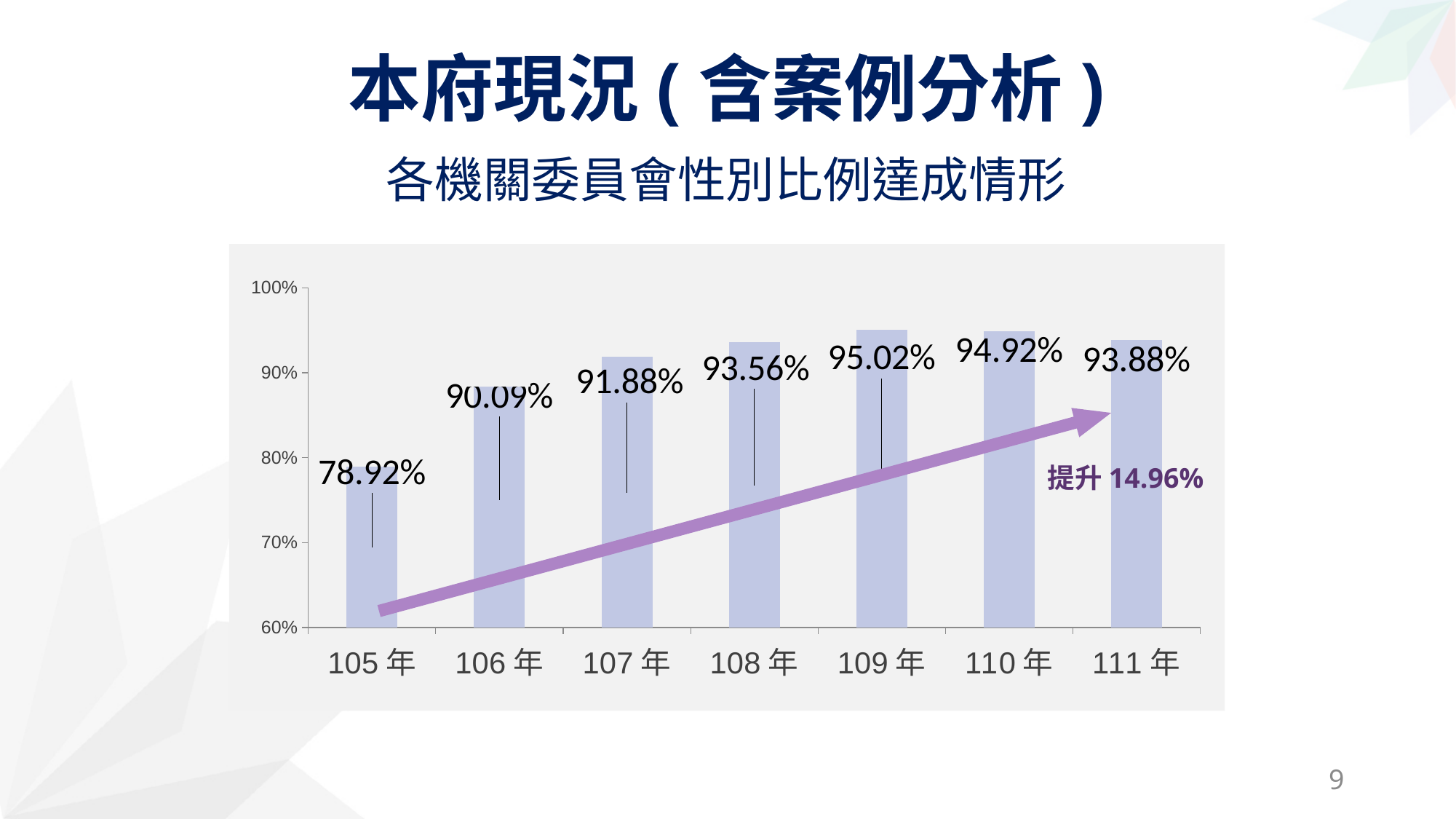
Which year has the lowest value? 105 年 What is the value for 107 年? 91.88% Do the values rise or fall from 105 年 to 109 年? rise What is the value for 105 年? 78.92% How many years are shown on the x axis? 7 What kind of chart is shown on the slide? bar chart What is the value for 109 年? 95.02% What is the difference between the values for 111 年 and 105 年? 14.96% Is the value for 105 年 greater or less than 80%? less Which year has the highest value? 109 年 Which is larger, the value for 108 年 or the value for 106 年? 108 年 What is the value for 111 年? 93.88%